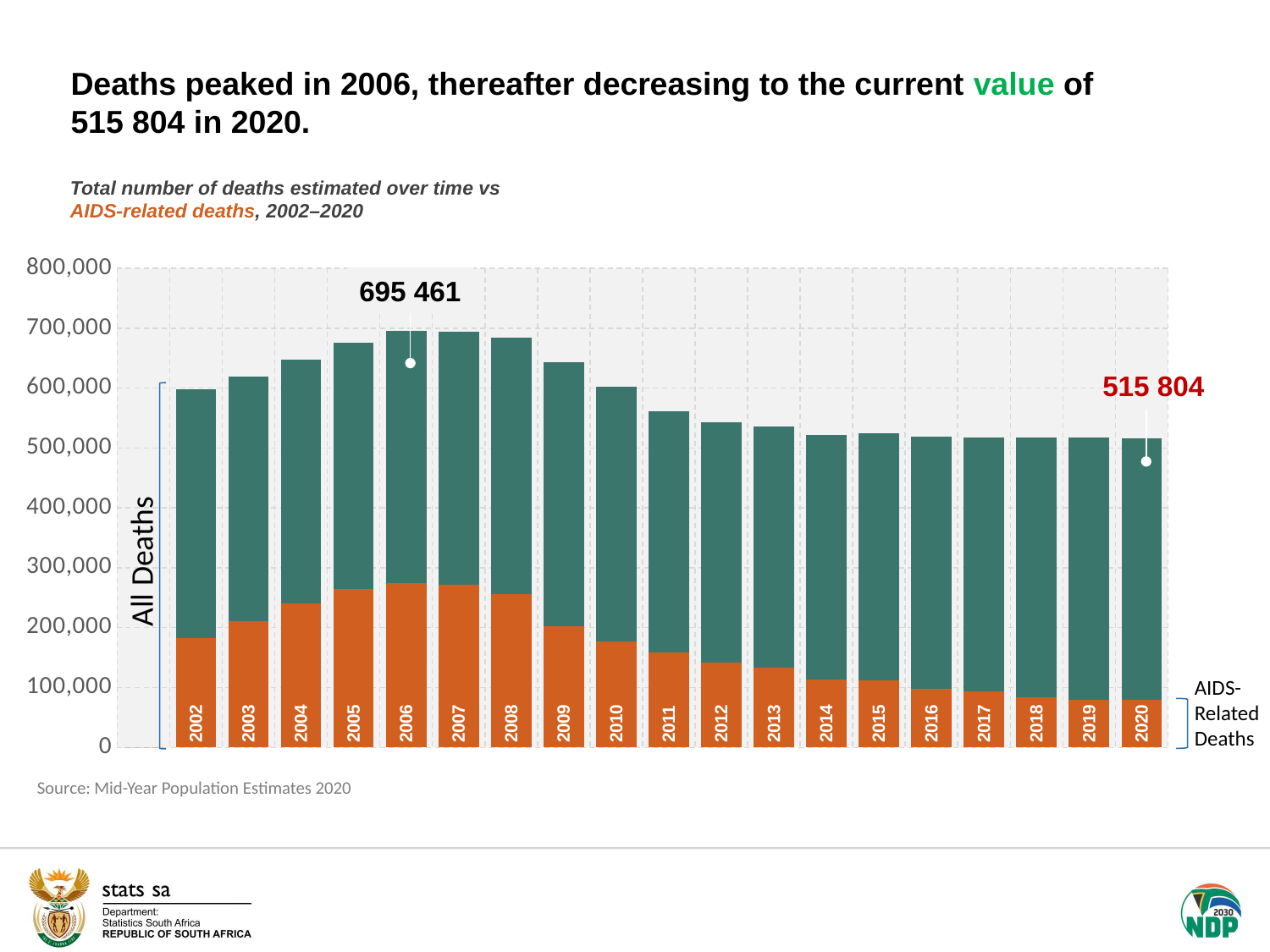
What is the total number of deaths shown for 2020? 515 804 In which year is the total number of deaths highest? 2006 Is the number of AIDS-related deaths for 2020 greater or less than 100,000? less Which year has more total deaths, 2006 or 2020? 2006 What is the source cited below the chart? Mid-Year Population Estimates 2020 Is the total number of deaths for 2005 greater or less than 600,000? greater What is the total number of deaths shown for 2006? 695 461 What kind of chart is shown on the slide? bar chart What is the difference between the total deaths in 2006 and in 2020? 179 657 Is the number of AIDS-related deaths for 2006 greater or less than 200,000? greater How many years are shown on the x axis of the chart? 19